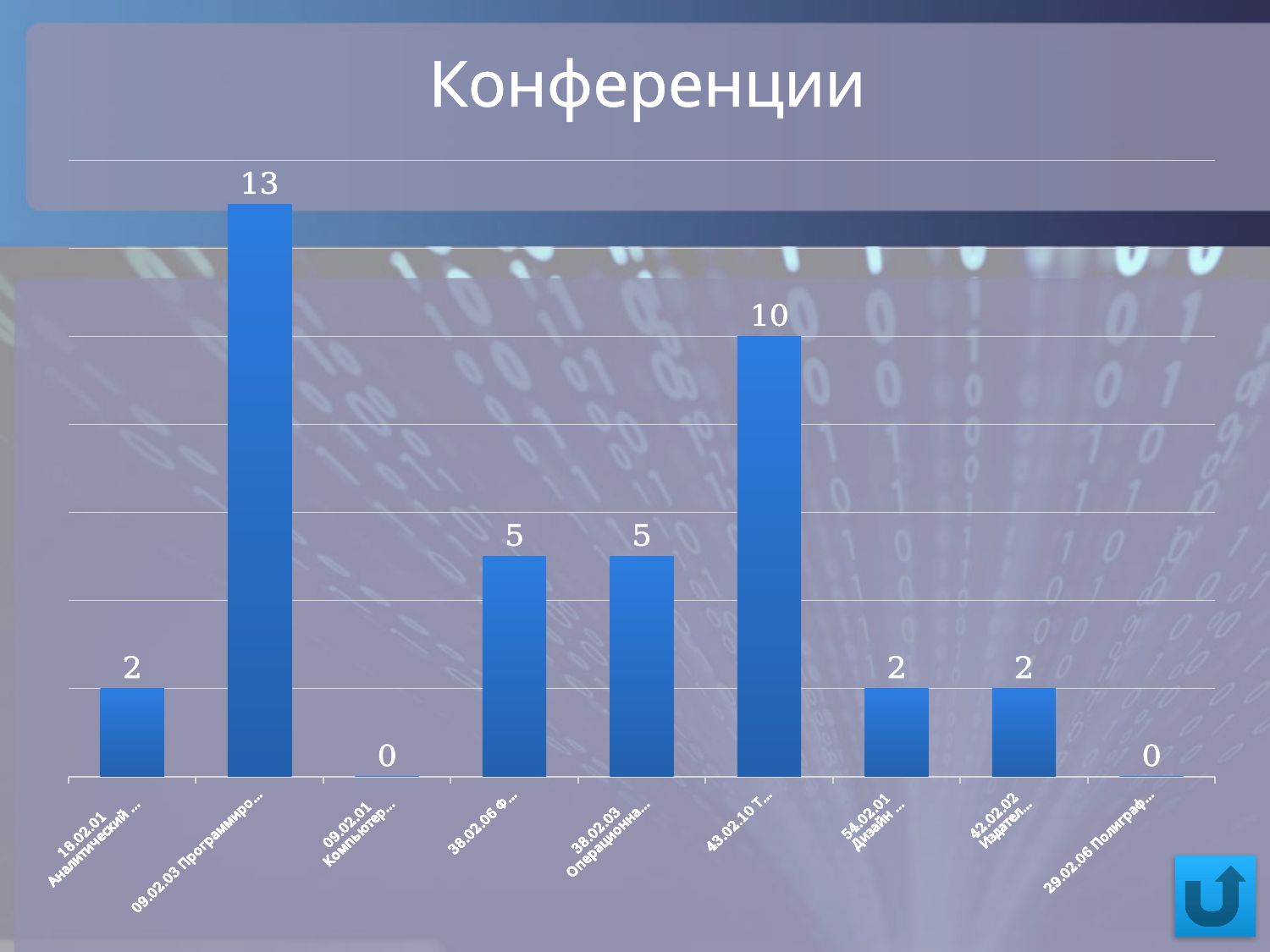
What is the difference between the values for 09.02.03 Программиро... and 43.02.10 Т...? 3 What is the title of the chart? Конференции Which category has the highest value? 09.02.03 Программиро... How many categories have a value of 0? 2 Which is larger, the value for 38.02.03 Операционна... or the value for 54.02.01 Дизайн ...? 38.02.03 Операционна... What is the value for the category 38.02.06 Ф...? 5 What is the value for the category 29.02.06 Полиграф...? 0 How many categories (bars) does the chart have? 9 What is the value for the category 09.02.03 Программиро...? 13 What is the value for the category 43.02.10 Т...? 10 What kind of chart is shown on the slide? bar chart What is the value for the category 18.02.01 Аналитический ...? 2